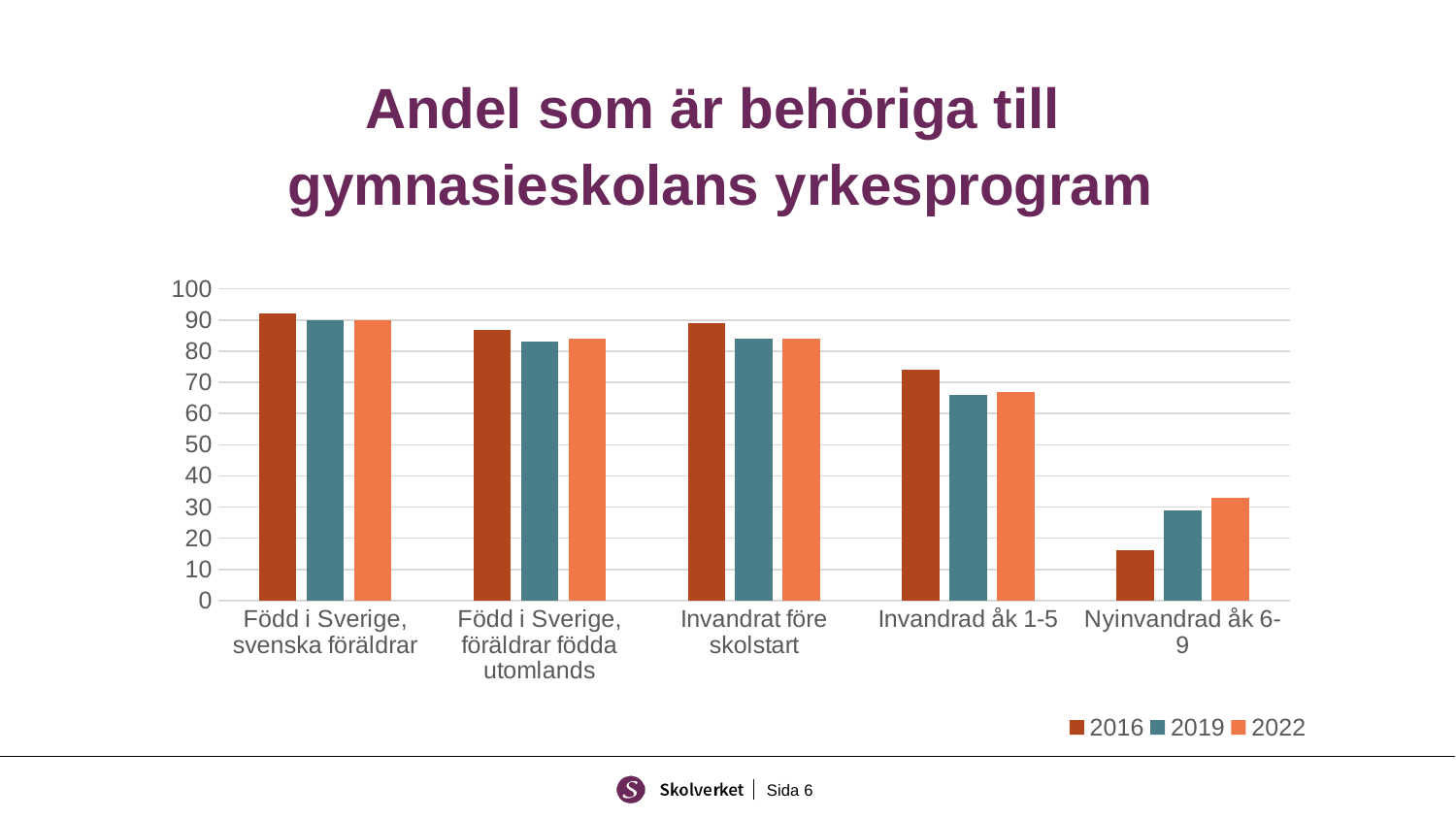
What kind of chart is shown on the slide? bar chart For Nyinvandrad åk 6-9, which is larger: the 2016 value or the 2022 value? 2022 Do the values for Nyinvandrad åk 6-9 rise or fall from 2016 to 2022? rise Which category has the lowest value for 2016? Nyinvandrad åk 6-9 How many categories are shown on the x axis? 5 Is the 2019 value for Invandrad åk 1-5 greater or less than 70? less How many series does the legend list? 3 For Invandrad åk 1-5, which is larger: the 2016 value or the 2019 value? 2016 Which category has the lowest value for 2022? Nyinvandrad åk 6-9 Is the 2016 value for Invandrat före skolstart greater or less than 80? greater What are the entries in the chart's legend? 2016, 2019, 2022 Is the 2016 value for Nyinvandrad åk 6-9 greater or less than 20? less